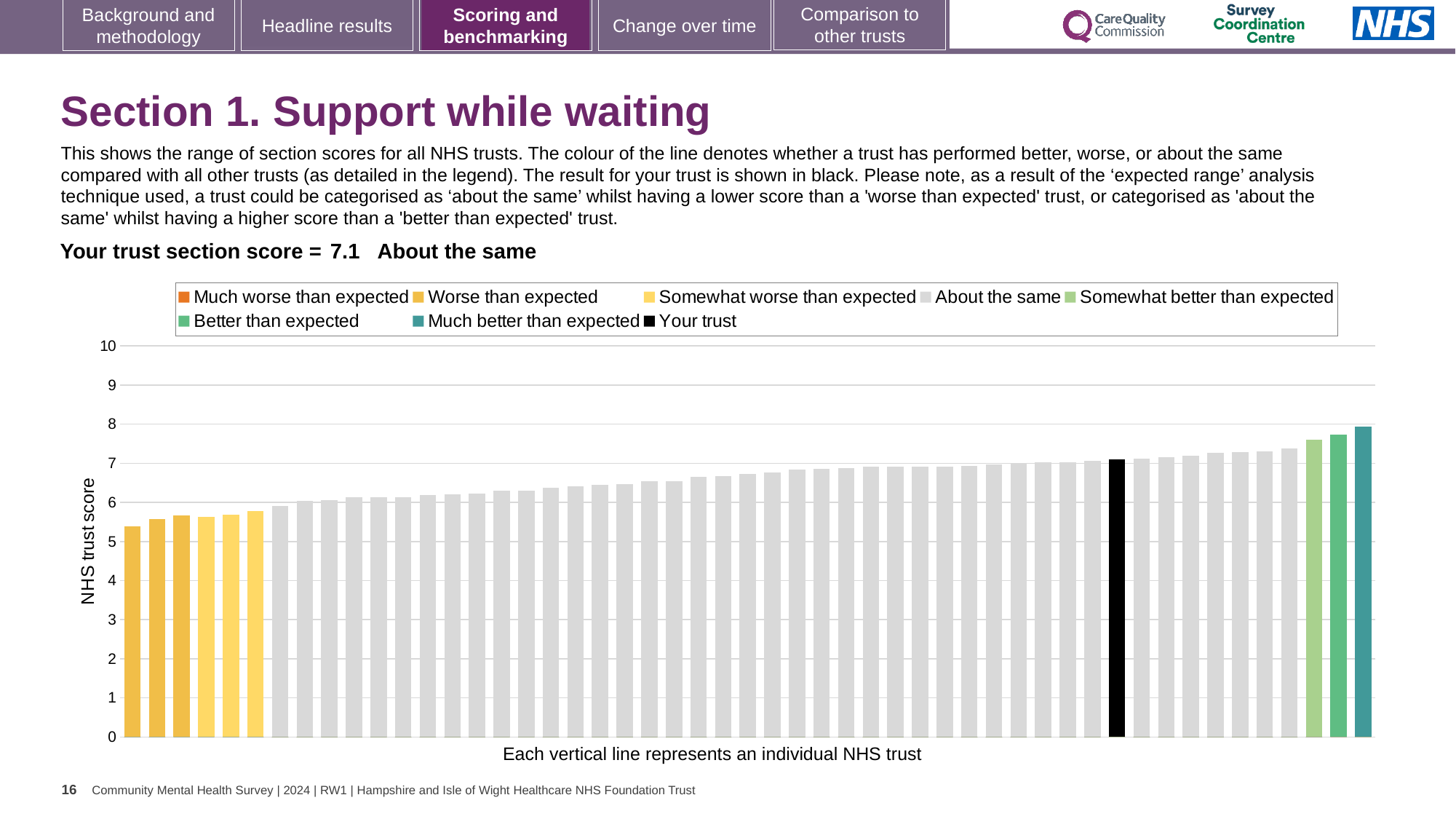
Is the value for the leftmost (lowest) bar greater or less than 6? less What is the section score for your trust? 7.1 What kind of chart is shown on the slide? Bar chart Which performance category is your trust placed in for this section? About the same What is the label on the vertical axis of the chart? NHS trust score Is the value for the rightmost (highest) bar greater or less than 7? greater What does each vertical line on the chart represent, according to the x-axis label? An individual NHS trust Which legend category does the highest bar on the chart belong to? Much better than expected How many entries does the chart legend list? 8 Do the bar values rise or fall from left to right along the x axis? rise Is the value for your trust (the black bar) greater or less than 6? greater